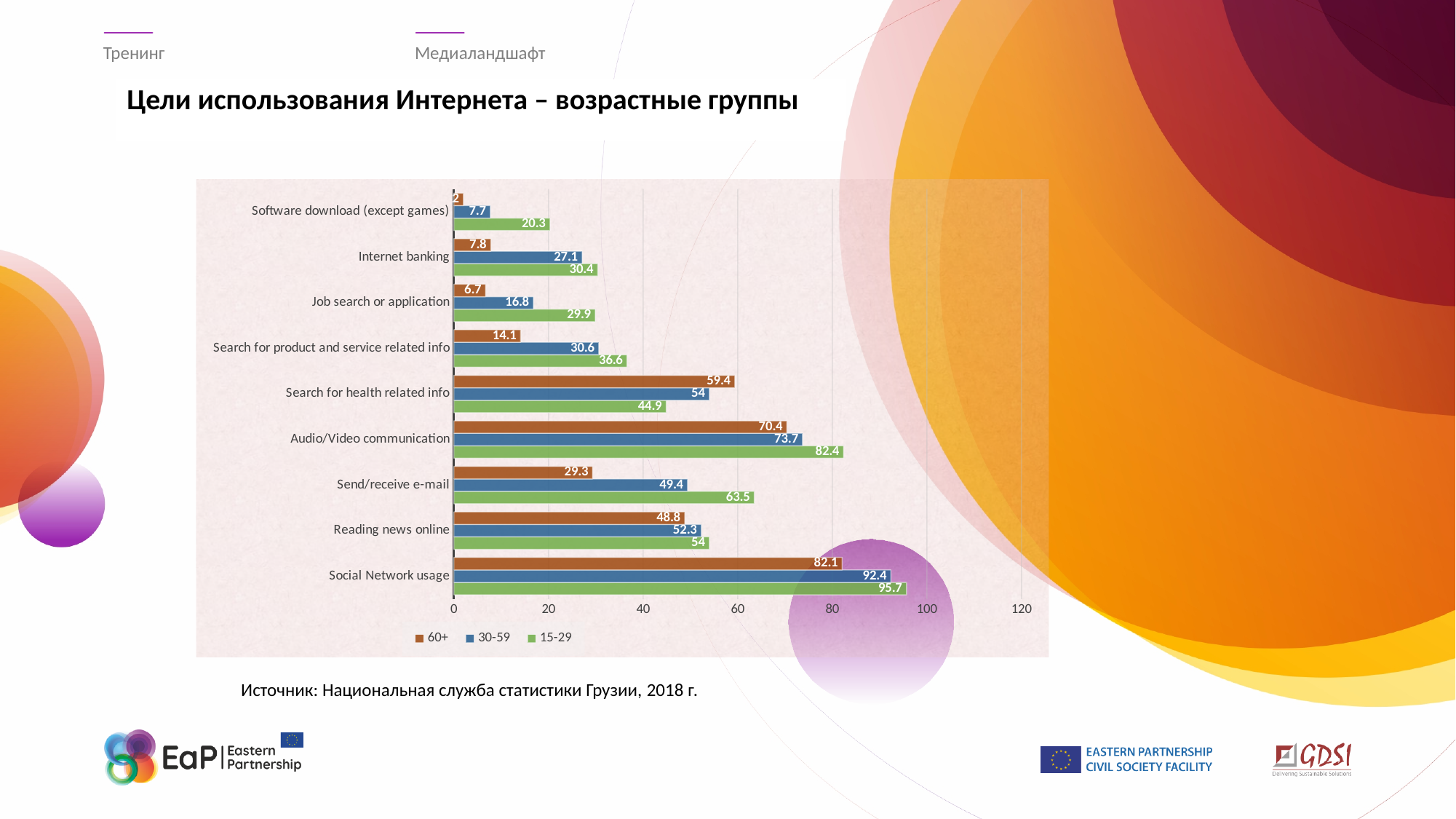
How many series does the legend list? 3 For Search for health related info, which group has the larger value, 60+ or 15-29? 60+ Is the value for the 30-59 group for Audio/Video communication greater or less than 60? greater Which category has the highest value for the 60+ group? Social Network usage What is the value for the 60+ group for Internet banking? 7.8 What is the value for the 30-59 group for Send/receive e-mail? 49.4 What is the difference between the 15-29 and 60+ values for Send/receive e-mail? 34.2 Which category has the lowest value for the 15-29 group? Software download (except games) Which series is shown in green in the legend? 15-29 How many categories are shown on the chart? 9 What is the value for the 15-29 group for Social Network usage? 95.7 What kind of chart is shown on the slide? bar chart